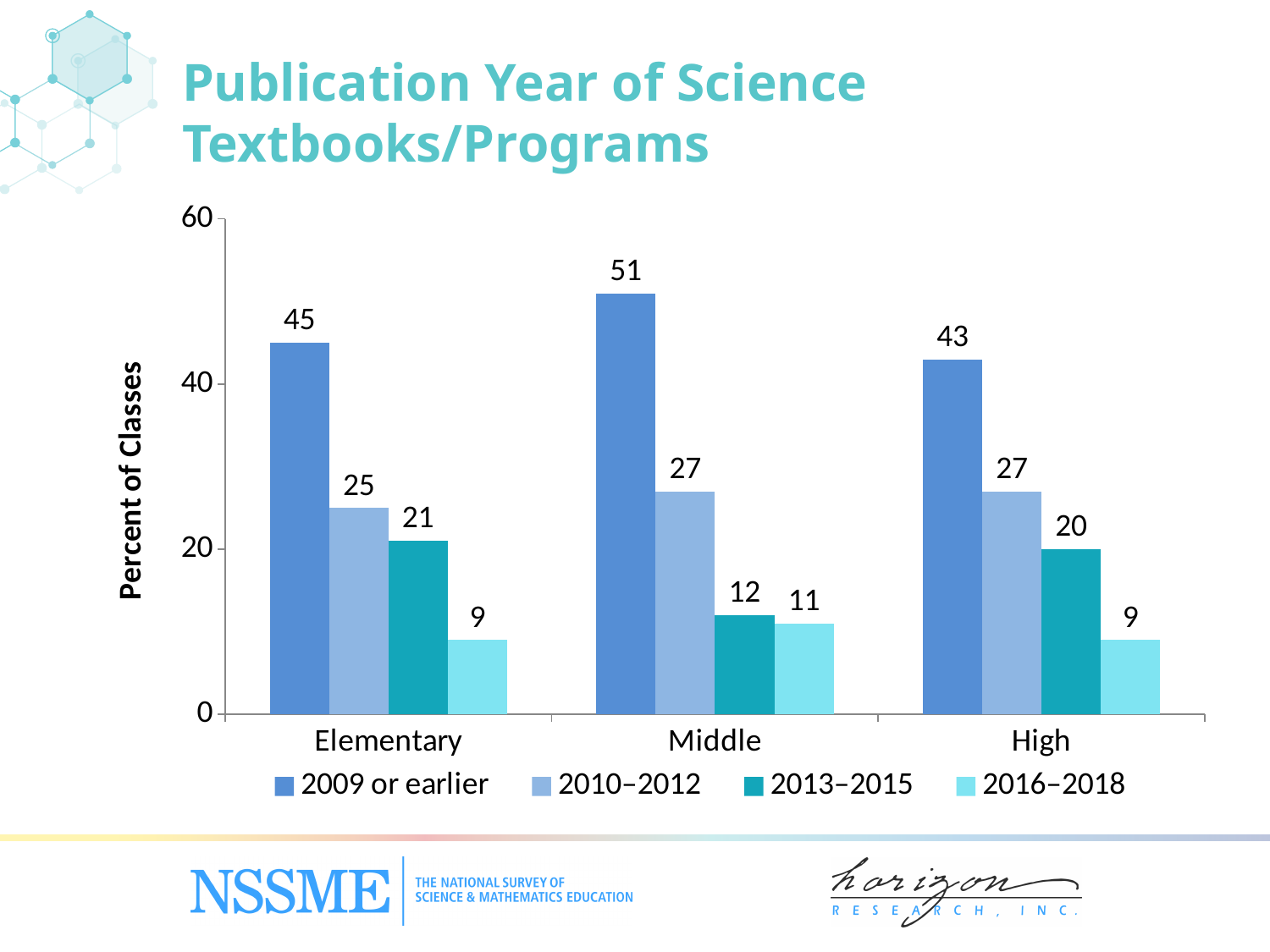
What is the value for 2009 or earlier in the Middle category? 51 Is the value for 2009 or earlier in the Elementary category greater or less than 40? greater What is the value for 2013–2015 in the Elementary category? 21 How many series does the legend list? 4 Which category has the highest value for 2009 or earlier? Middle How many categories are shown on the x axis? 3 What is the difference between the 2009 or earlier values for Middle and High? 8 Which category has the lowest value for 2013–2015? Middle What is the label of the y axis? Percent of Classes What is the value for 2016–2018 in the High category? 9 Which is larger: the 2010–2012 value for Elementary or for Middle? Middle What kind of chart is shown on the slide? bar chart